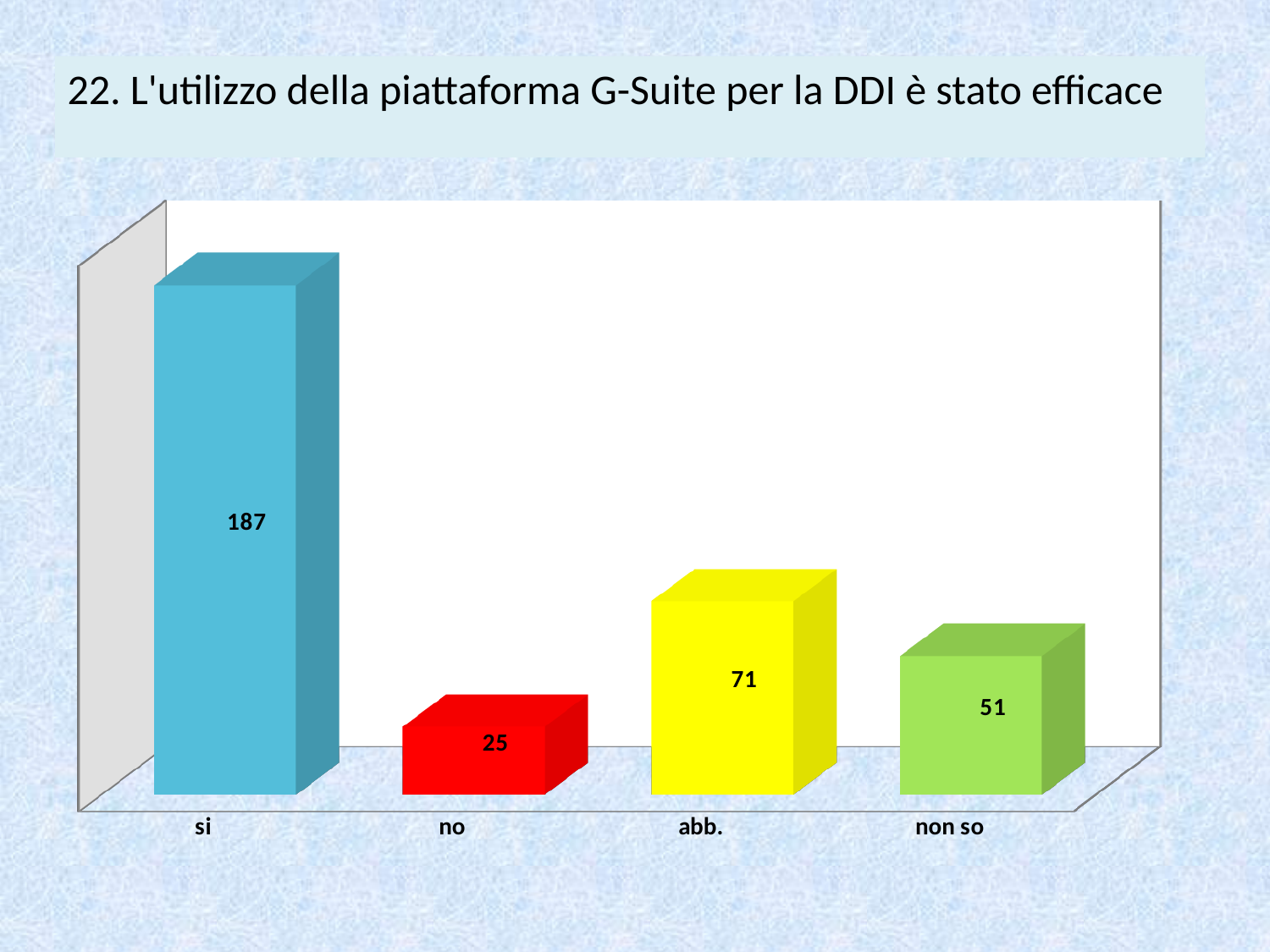
What is the difference between the values for "si" and "abb."? 116 What is the value for "si"? 187 What colour is the bar for "no"? red What is the value for "no"? 25 What is the value for "abb."? 71 Which category has the lowest value? no What kind of chart is shown on the slide? bar chart What is the difference between the values for "abb." and "non so"? 20 What is the value for "non so"? 51 Which category has the highest value? si How many categories are shown on the x axis? 4 Which is larger, the value for "abb." or the value for "non so"? abb.